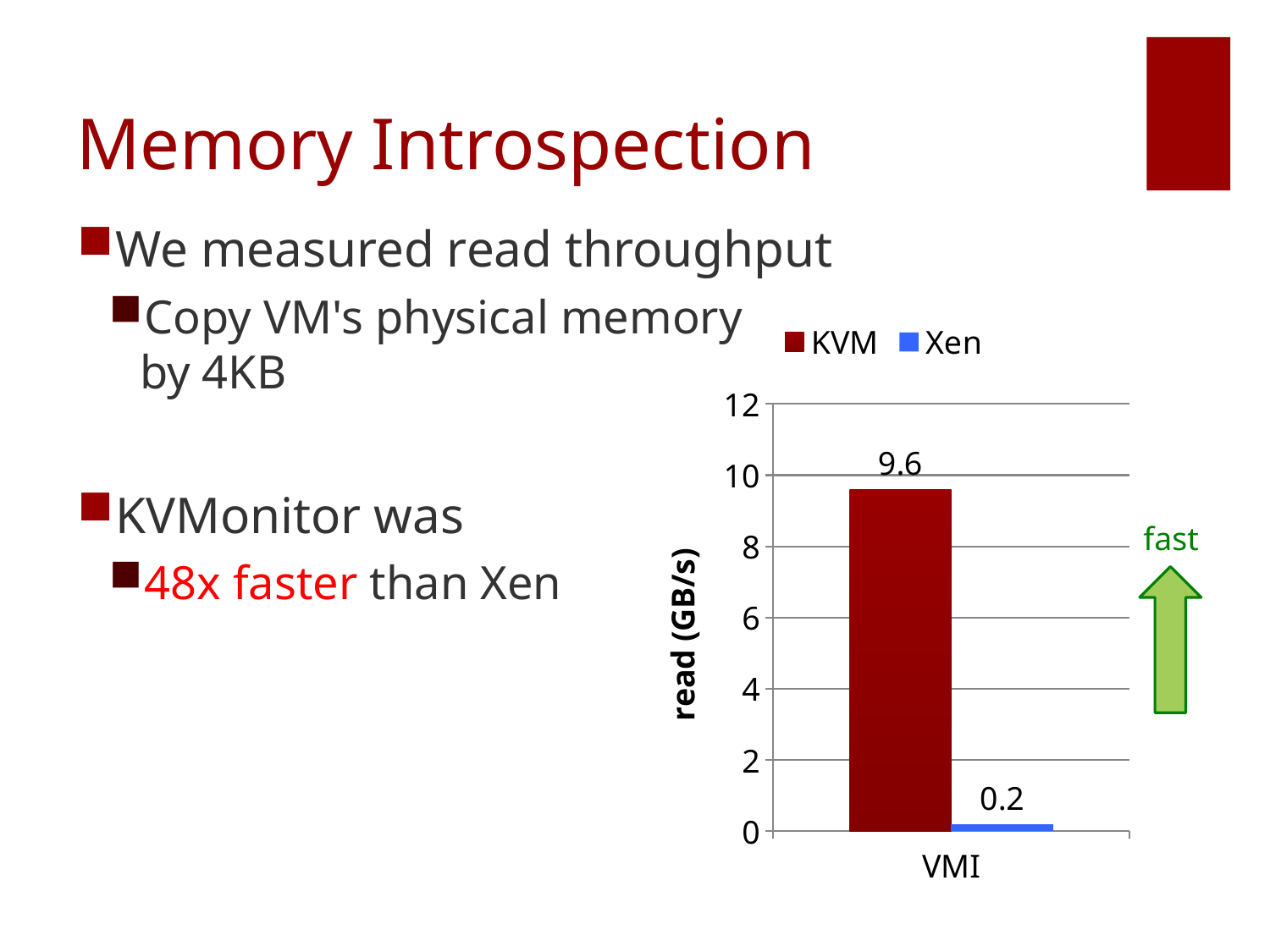
How many categories are shown on the x axis? 1 Which series has the higher read throughput, KVM or Xen? KVM How many series does the legend list? 2 Is the value for Xen greater or less than 2? less What is the difference between the KVM and Xen read throughput values? 9.4 What kind of chart is shown on the slide? bar chart What is the read throughput for Xen in the VMI category? 0.2 Is the value for KVM greater or less than 8? greater What is the category label on the x axis? VMI Which series has the lowest read throughput? Xen What is the label of the y axis? read (GB/s) What is the read throughput for KVM in the VMI category? 9.6